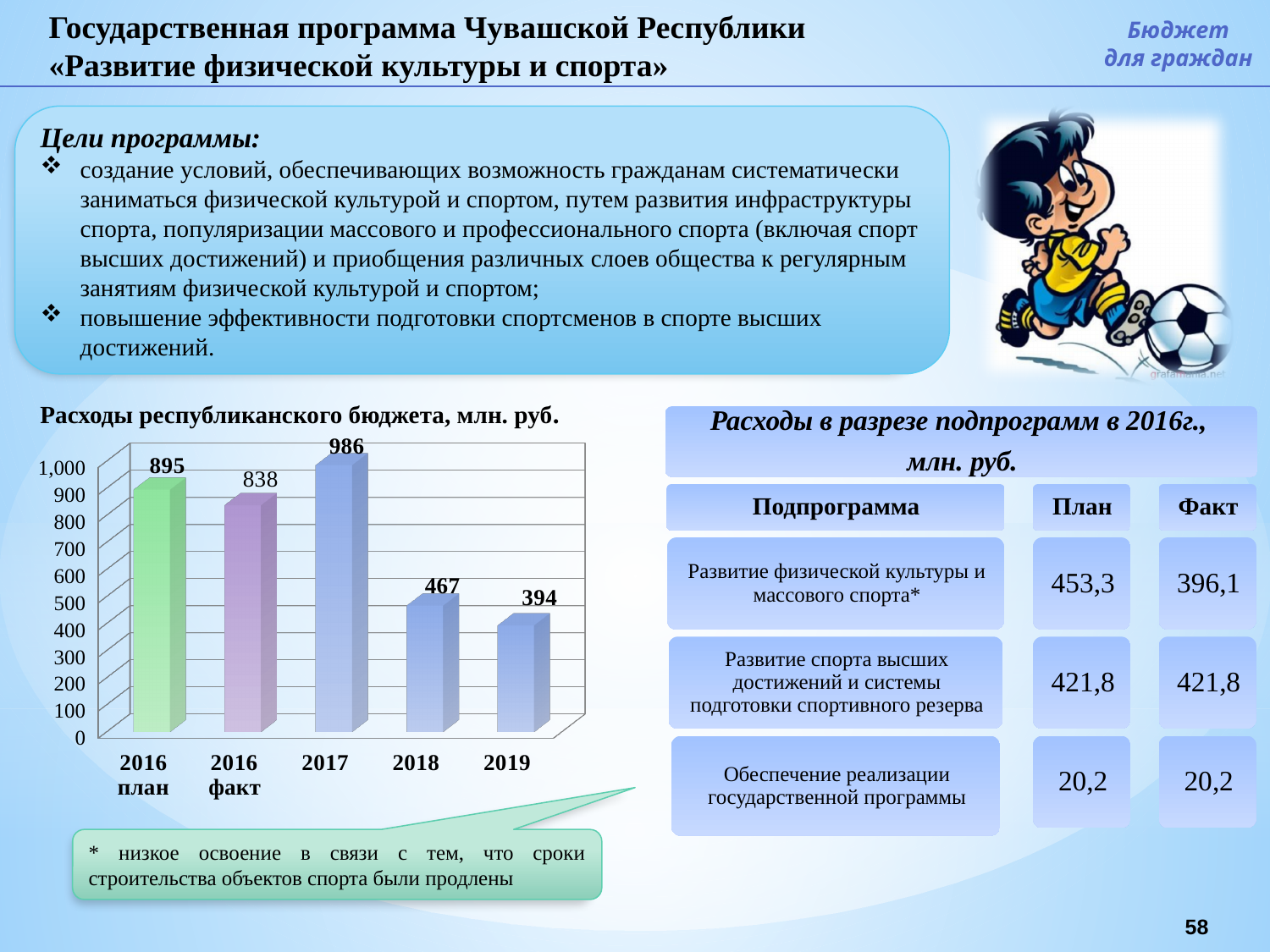
Which category has the highest value in the chart? 2017 What is the difference between the values for 2017 and 2018? 519 How many bars are shown in the chart? 5 What is the value for '2016 факт' in the chart? 838 Which is larger, the value for 2018 or the value for 2019? 2018 Is the value for 2018 greater or less than 500? less What is the value for 2019 in the chart? 394 What is the difference between the values for '2016 план' and '2016 факт'? 57 What is the title of the chart on the slide? Расходы республиканского бюджета, млн. руб. What is the value for 2017 in the chart 'Расходы республиканского бюджета, млн. руб.'? 986 What kind of chart is shown on the slide? bar chart Which category has the lowest value in the chart? 2019